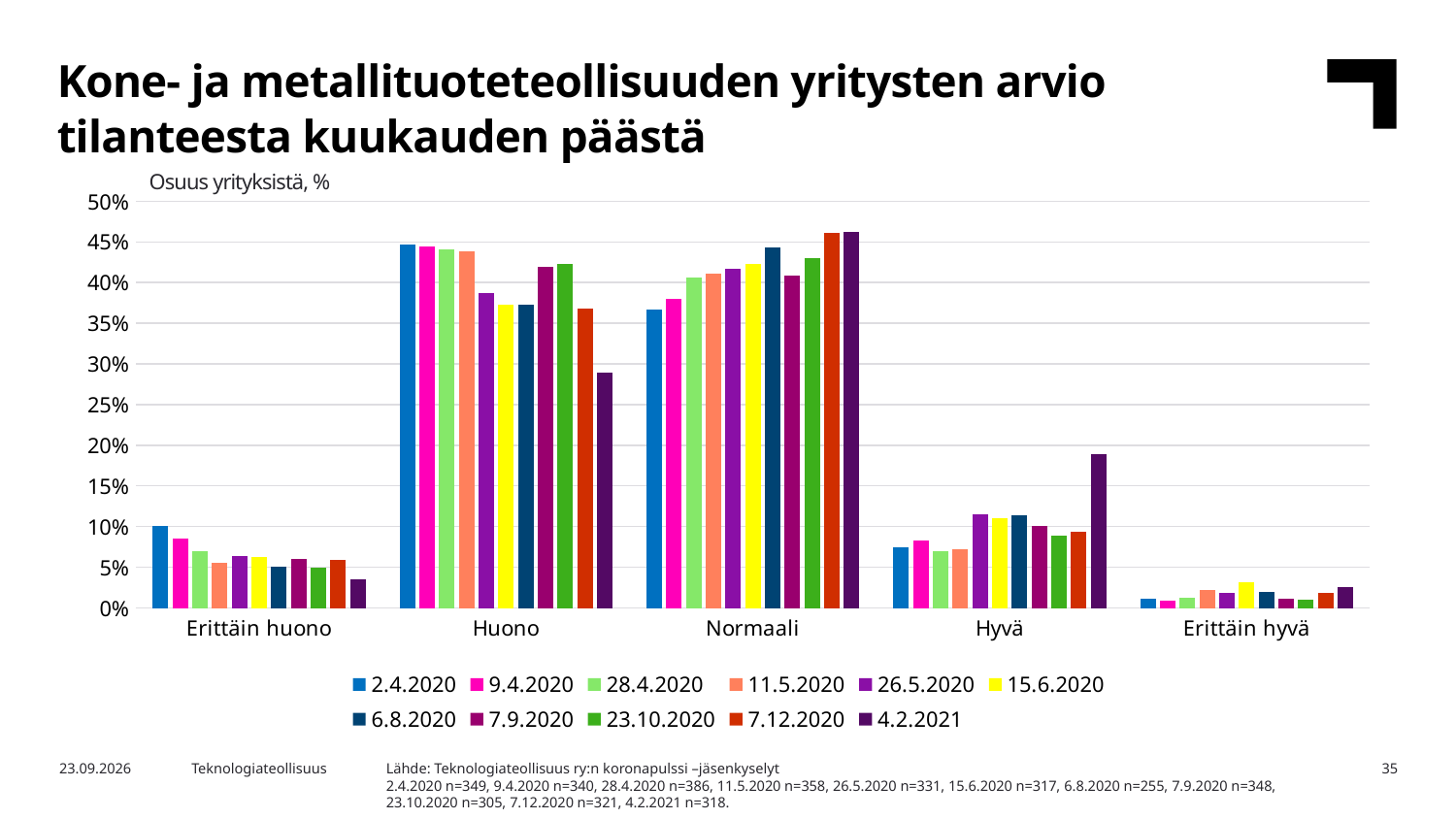
Is the value for 7.12.2020 in the Normaali category greater or less than 40%? greater For the 4.2.2021 series, which category has the highest bar? Normaali What is the label shown above the y axis? Osuus yrityksistä, % Is the value for 2.4.2020 in the Erittäin huono category greater or less than 5%? greater In the Hyvä category, which series has the highest bar? 4.2.2021 What kind of chart is shown on the slide? bar chart Is the value for 4.2.2021 in the Huono category greater or less than 35%? less How many categories are shown on the x axis? 5 In the Huono category, which series has the lowest bar? 4.2.2021 How many series does the legend list? 11 In the Erittäin huono category, which is larger: the value for 2.4.2020 or for 4.2.2021? 2.4.2020